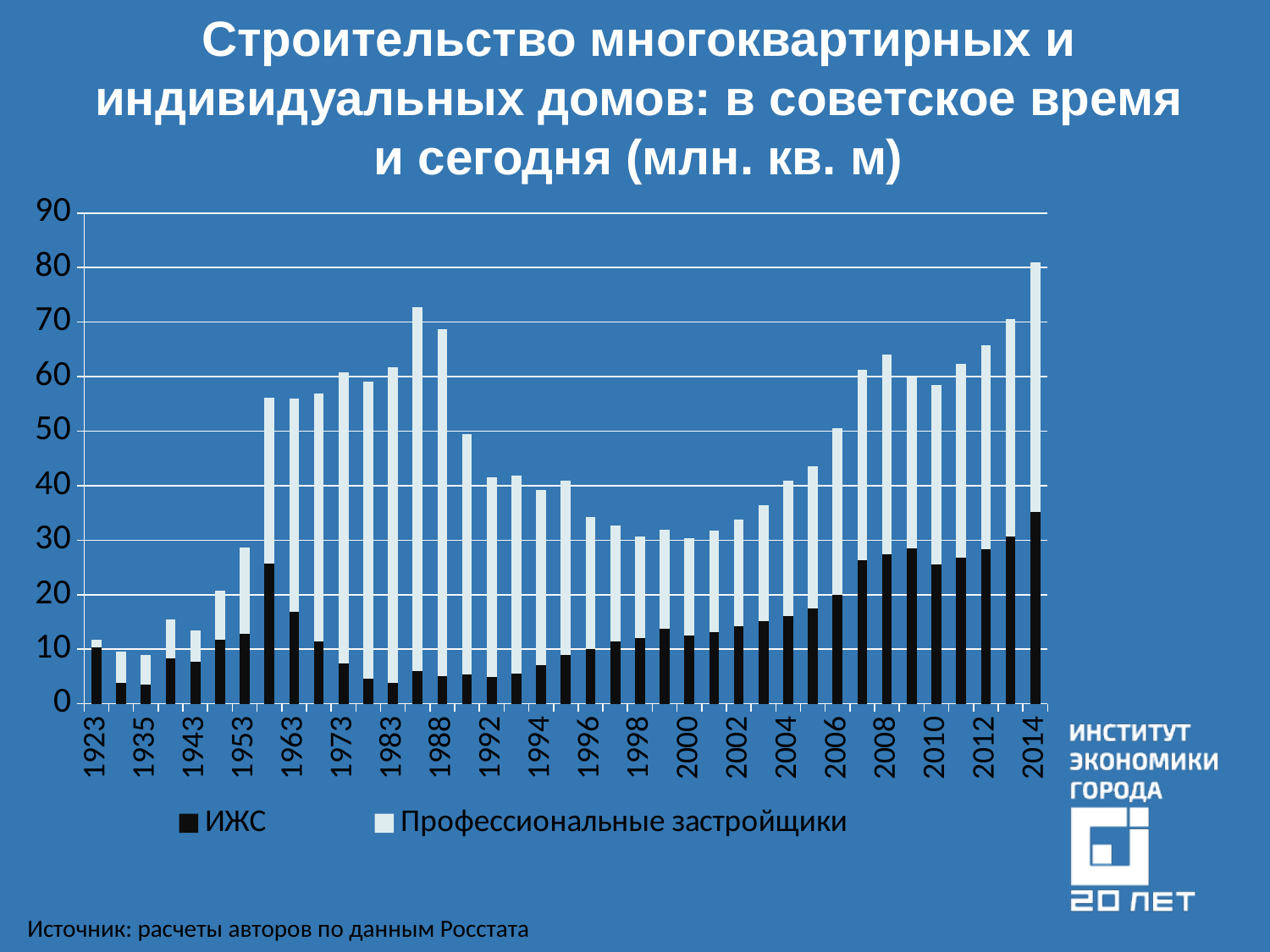
Which year has the highest total bar? 2014 Which series is shown in black? ИЖС Do the total bars rise or fall from 1996 to 2014? rise Is the total value for 2014 greater or less than 70? greater What kind of chart is shown on the slide? stacked bar chart Which year has the larger ИЖС value, 1923 or 2014? 2014 What are the two series named in the legend? ИЖС and Профессиональные застройщики How many series does the legend list? 2 Is the total value for 1998 greater or less than 40? less Is the total value for 1923 greater or less than 20? less Which year has the larger total bar, 1988 or 1998? 1988